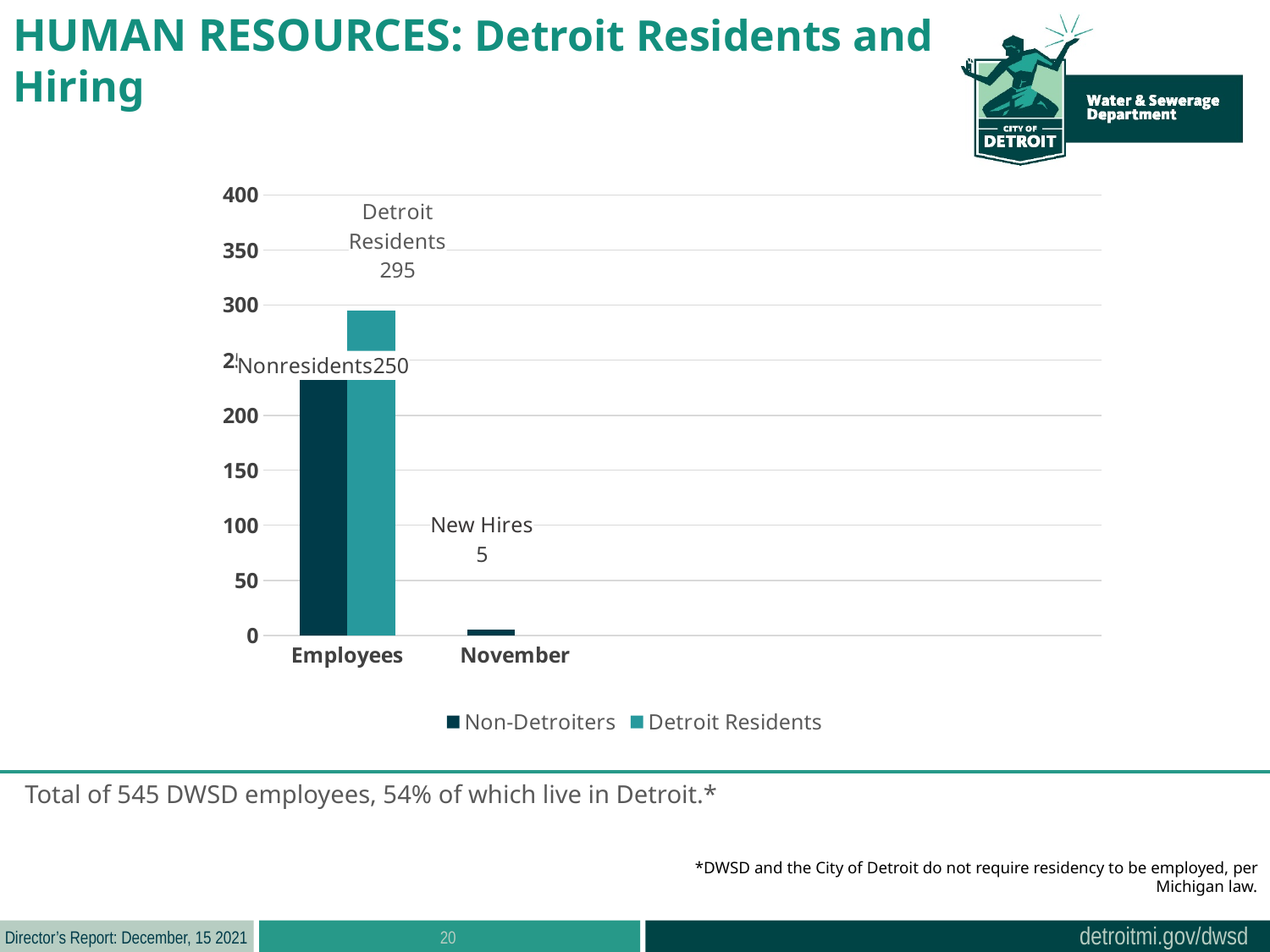
How many series does the legend list? 2 What is the difference between Detroit Residents (295) and Nonresidents (250) in the Employees category? 45 In the Employees category, which is larger: Detroit Residents or Nonresidents? Detroit Residents How many categories are shown on the x axis? 2 What is the value for Nonresidents in the Employees category? 250 Which category has the lowest bar on the chart? November What are the two series named in the legend? Non-Detroiters and Detroit Residents Is the Detroit Residents value for Employees greater or less than 250? greater What is the value for Detroit Residents in the Employees category? 295 What is the total of the Employees bars (Detroit Residents 295 plus Nonresidents 250)? 545 What kind of chart is shown on the slide? bar chart What is the value labelled New Hires in the November category? 5